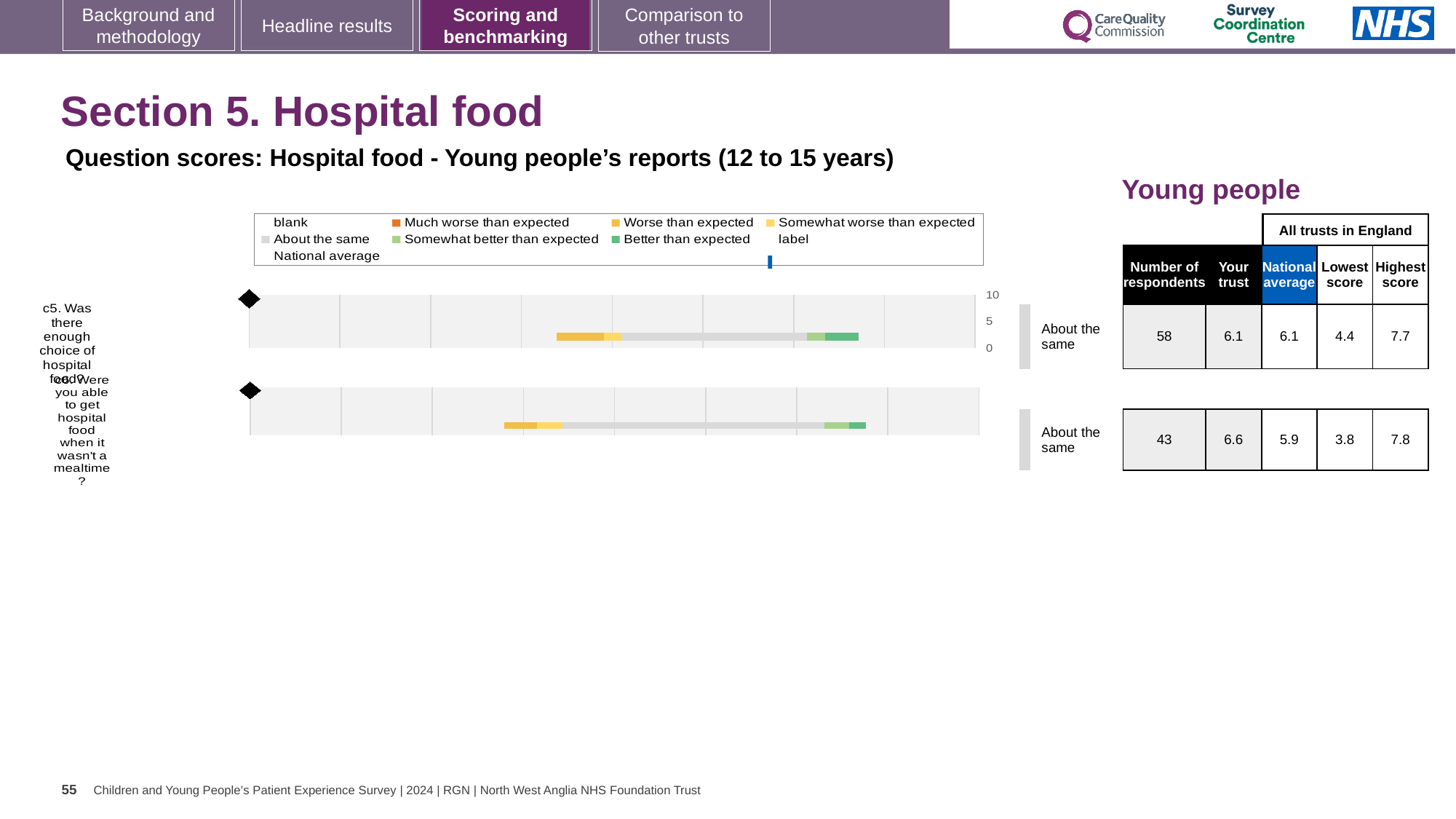
How many questions (categories) are plotted in the hospital food charts? 2 What benchmark category is shown next to the chart for question c6? About the same In the table beside the charts, what is the national average for c6? 5.9 Which legend entry is shown with a dark green colour? Better than expected In the table beside the charts, what is the 'Your trust' score for c6 (getting hospital food when it wasn't a mealtime)? 6.6 What benchmark category is shown next to the chart for question c5? About the same What is the difference between the highest score (7.8) and the lowest score (3.8) for c6 in the table? 4.0 What is the highest value shown on the chart's axis? 10 In the table beside the charts, how many respondents answered c5? 58 Which question has the higher 'Your trust' score in the table, c5 or c6? c6 In the table beside the charts, what is the 'Your trust' score for c5 (enough choice of hospital food)? 6.1 What kind of chart is used to show the question scores for c5 and c6? bar chart